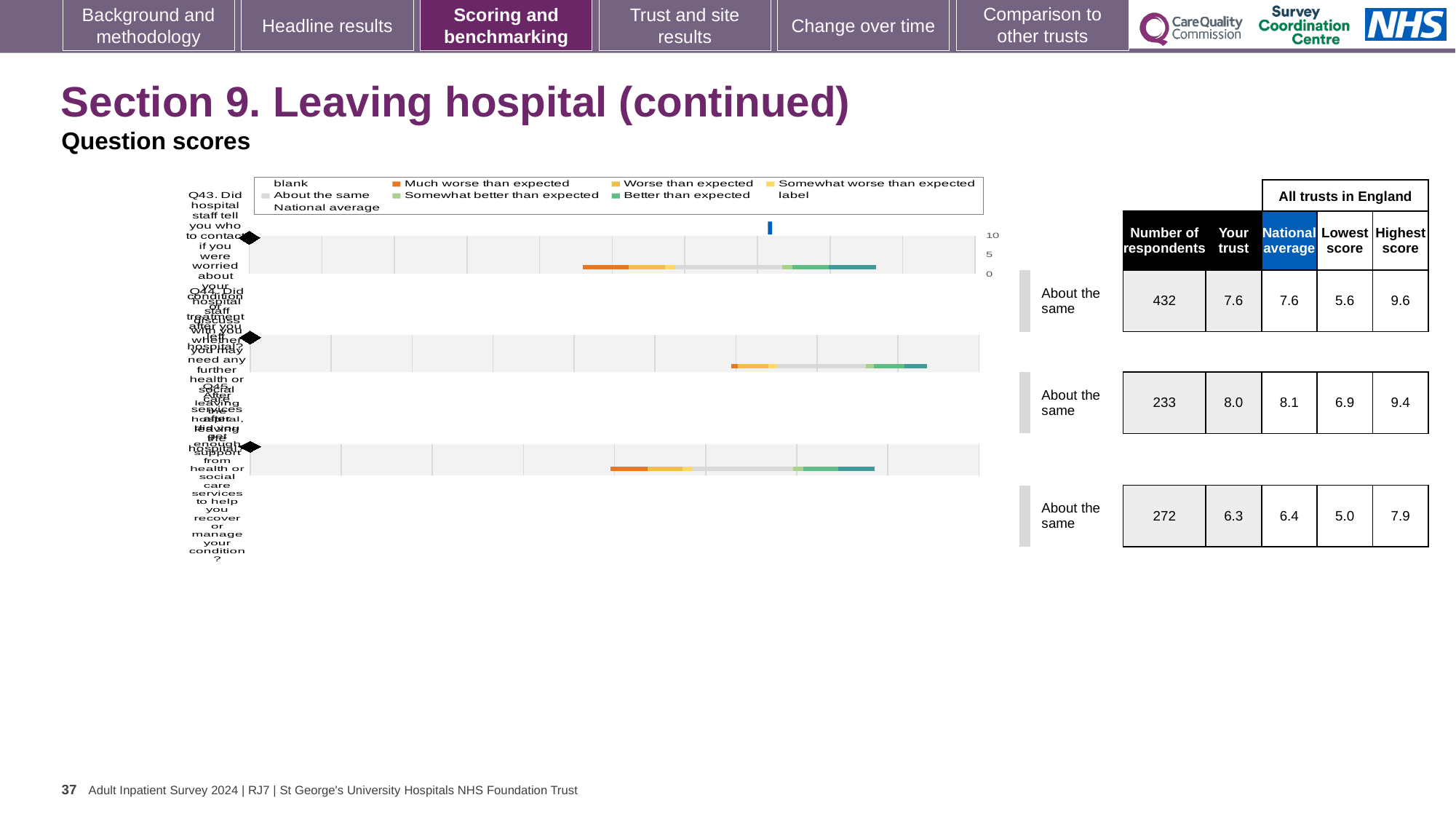
What kind of chart is shown on the slide? bar chart In the table beside the chart, what is the highest score in England for the third question? 7.9 In the table beside the chart, what is the 'Your trust' score for the first question (Q43)? 7.6 In the table beside the chart, what is the national average for the second question? 8.1 Which legend entry is shown in dark orange? Much worse than expected What benchmark category is shown next to each of the three bars? About the same In the table beside the chart, what is the difference between the highest and lowest scores for the first question (Q43)? 4.0 How many question bars are plotted in the chart? 3 In the table beside the chart, what is the number of respondents for the first question (Q43)? 432 In the table beside the chart, which question has the largest number of respondents? Q43 (the first question) In the table beside the chart, for the third question, which is larger: the 'Your trust' score or the national average? National average What is the maximum value shown on the chart's score axis? 10